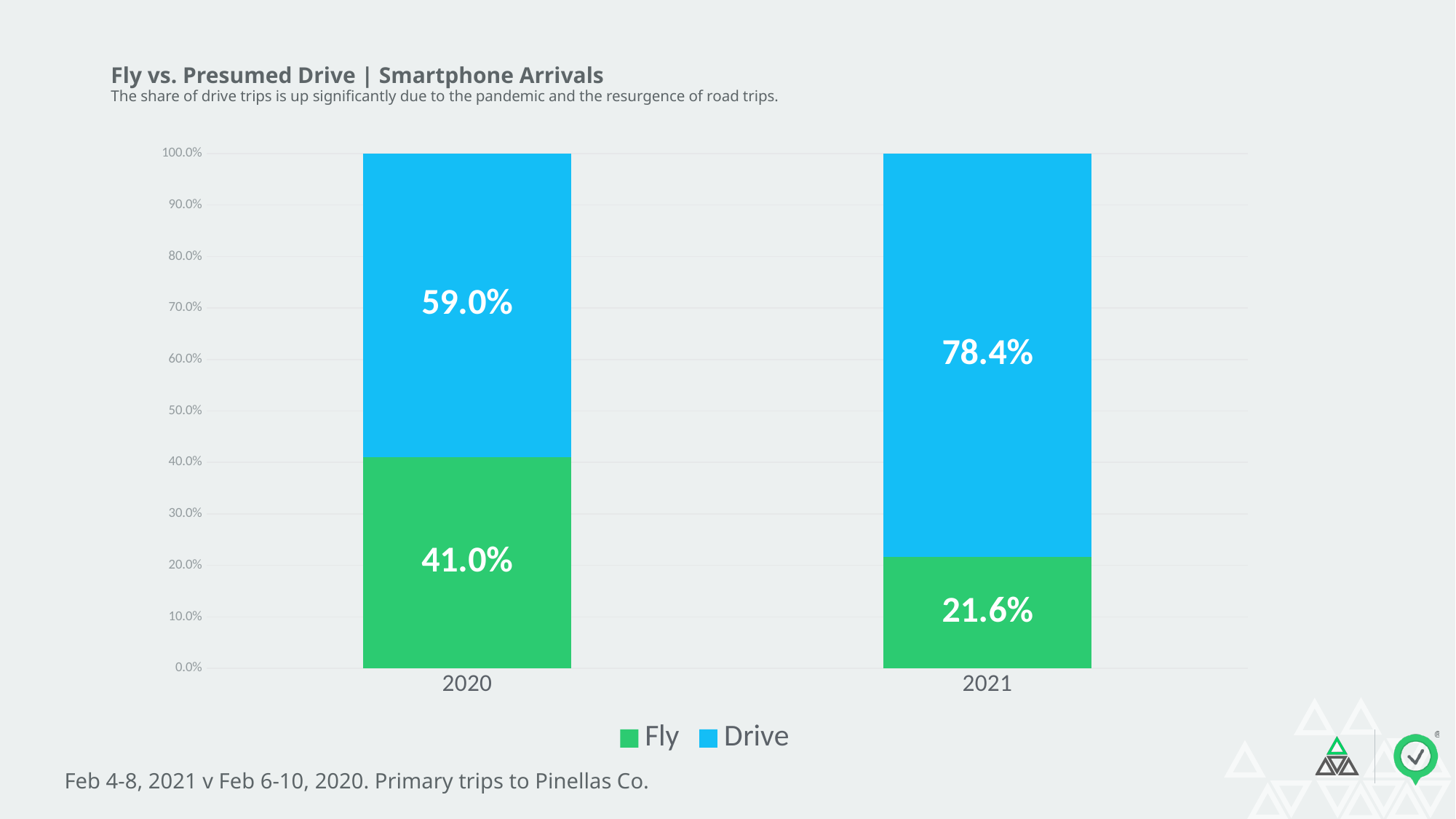
What is the total of the stacked bar for 2021? 100.0% What kind of chart is shown? Stacked bar chart How many years are shown on the x axis? 2 Which year has the lower Fly share? 2021 What is the Fly share for 2021? 21.6% Is the Fly share for 2020 larger or smaller than the Fly share for 2021? larger What is the Drive share for 2020? 59.0% Which year has the higher Drive share? 2021 By how many percentage points did the Drive share change from 2020 to 2021? 19.4 percentage points What is the Fly share for 2020? 41.0% What is the Drive share for 2021? 78.4% How many series does the legend list? 2